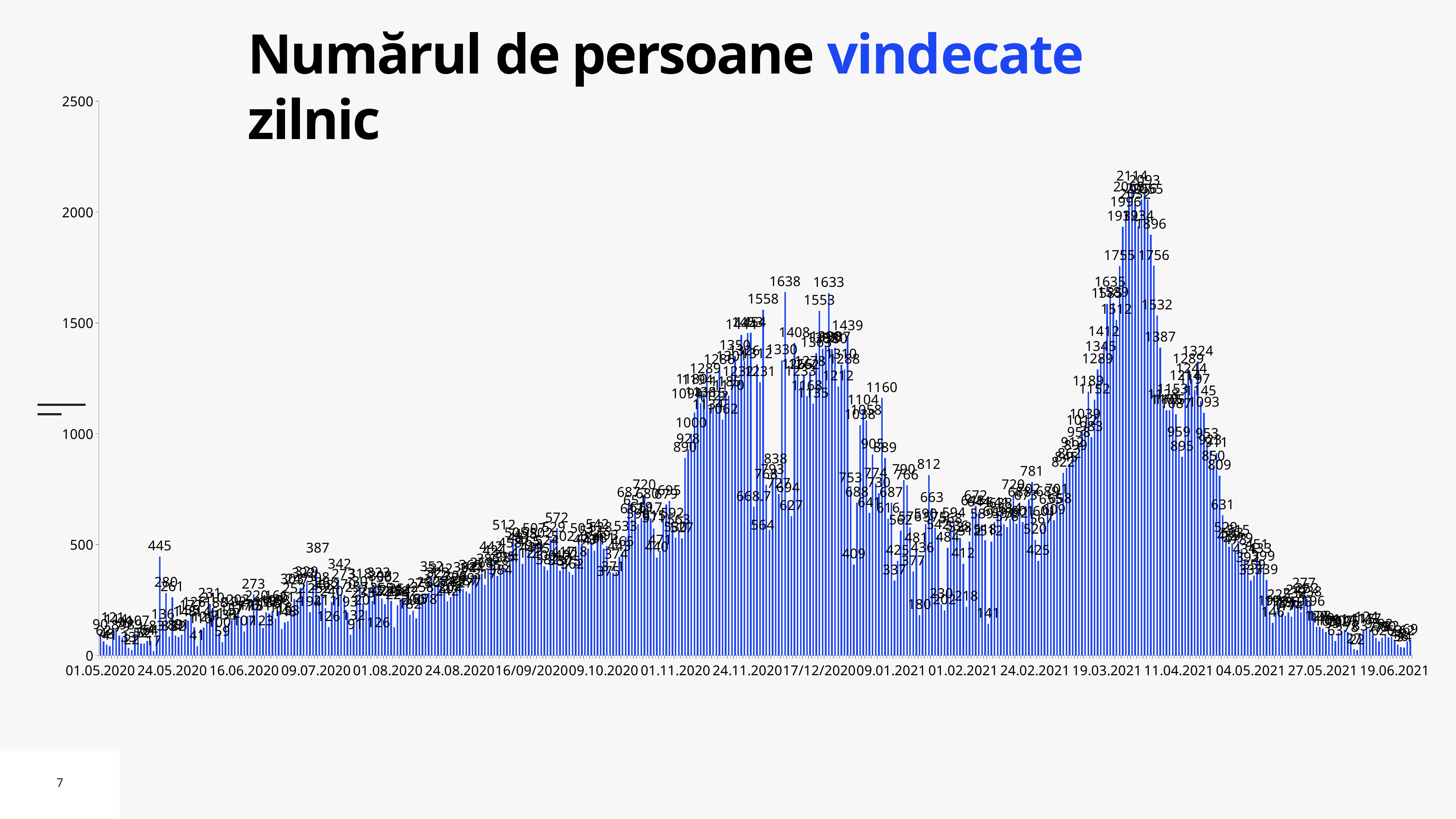
What is the highest value labelled in May 2020? 445 Is the highest value on the chart greater or less than 2000? greater What is the difference between the April 2021 peak (2114) and the late November 2020 peak (1638)? 476 What is the maximum value shown on the vertical axis? 2500 Which peak is higher: the one in late November 2020 or the one in April 2021? April 2021 Is the highest value in May 2020 greater or less than 500? less What is the title of the chart? Numărul de persoane vindecate zilnic Do the values rise or fall between 11.04.2021 and 27.05.2021? fall What kind of chart is shown on the slide? bar chart What is the highest daily value labelled on the chart? 2114